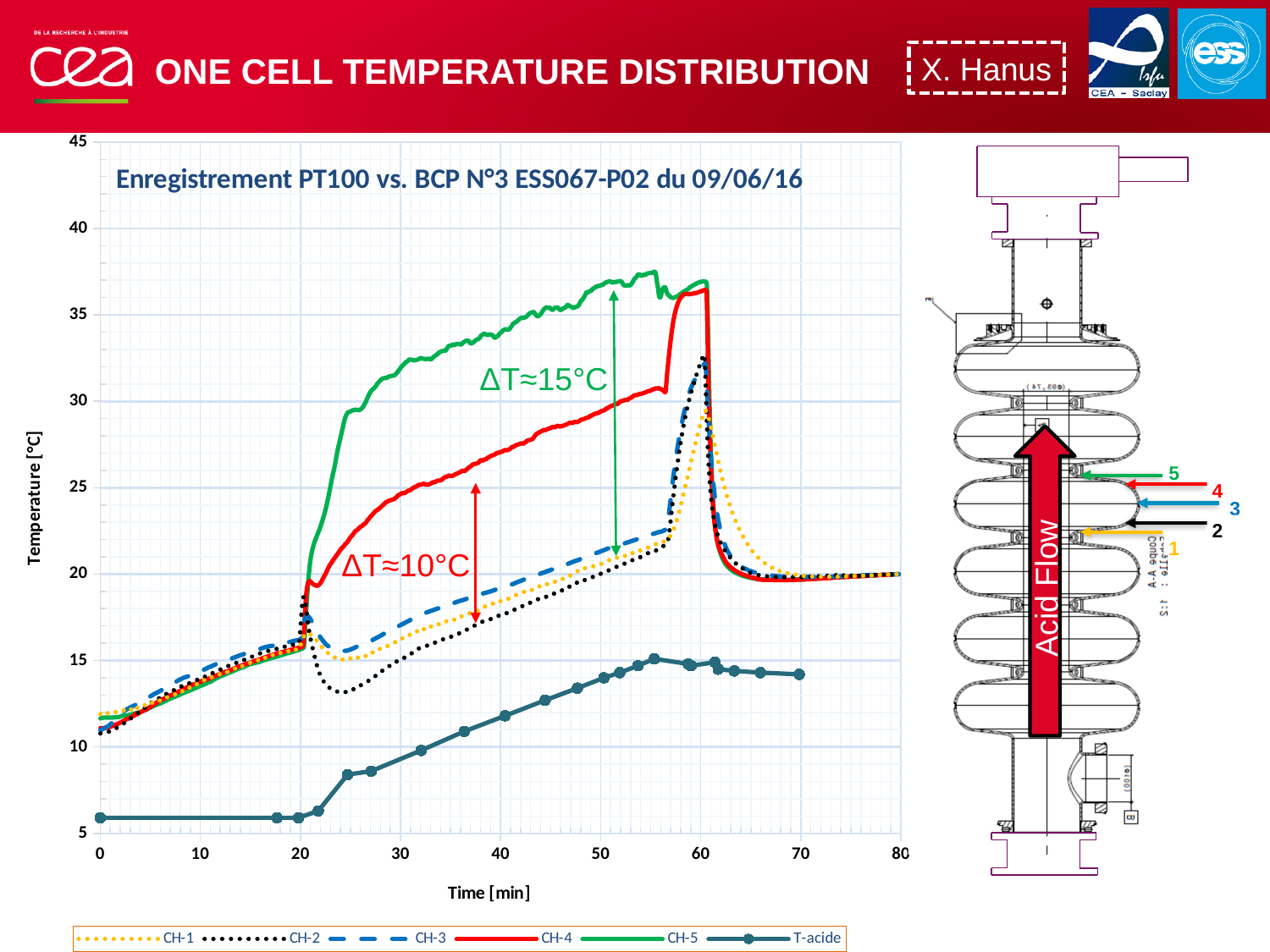
Which series has the highest temperature at 50 min? CH-5 Is the T-acide value at 55 min greater or less than 10? greater Is the T-acide value at 0 min greater or less than 10? less What kind of chart is shown on the slide? line chart How many series does the chart legend list? 6 Does the T-acide series rise or fall between 20 min and 55 min? rise At 40 min, which series has the higher temperature, CH-4 or CH-5? CH-5 Which series has the lowest temperature at 50 min? T-acide Is the CH-5 value at 50 min greater or less than 30? greater What is the title of the chart? Enregistrement PT100 vs. BCP N°3 ESS067-P02 du 09/06/16 What temperature difference does the green arrow annotation on the chart indicate? ΔT≈15°C